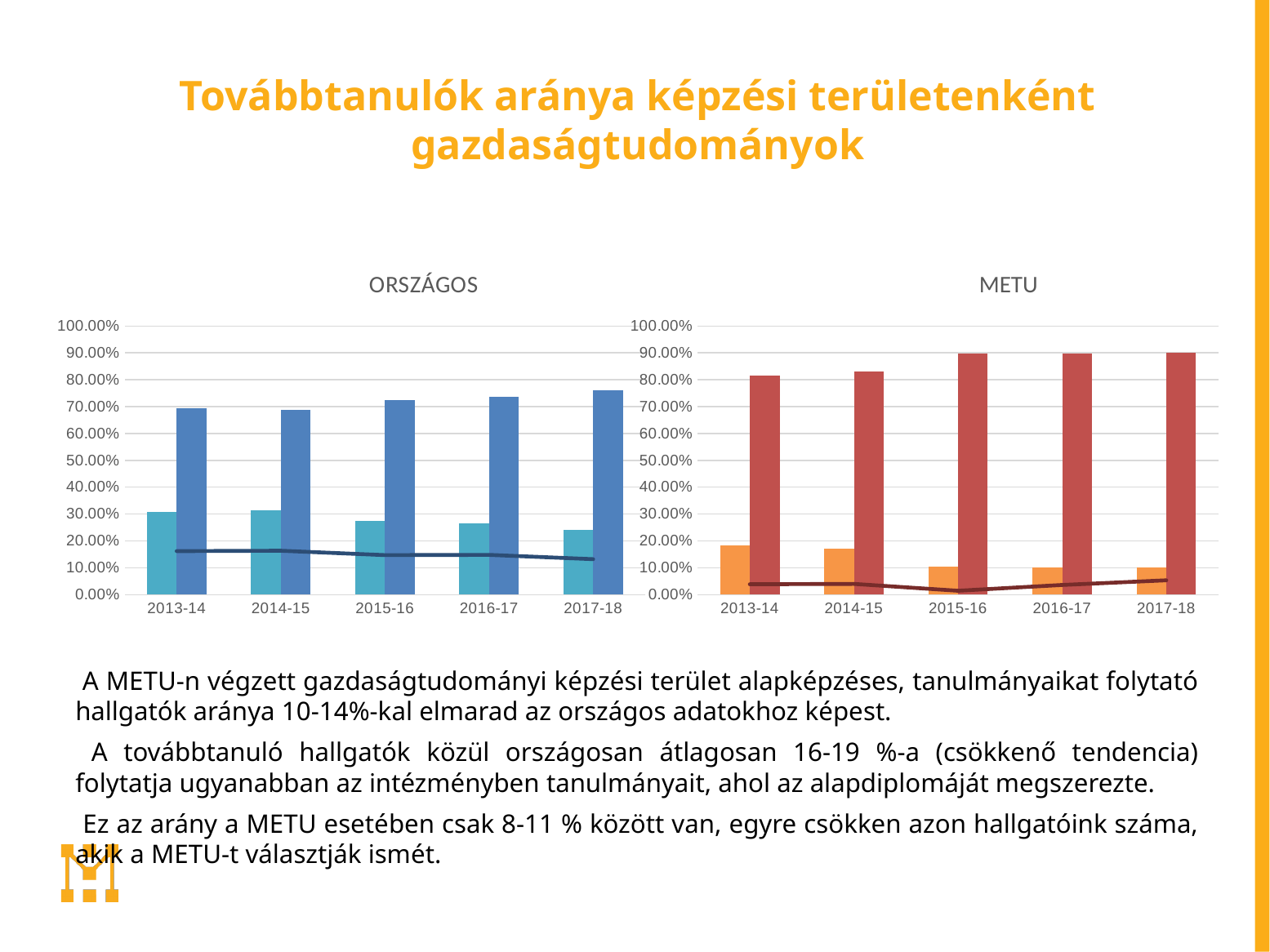
What are the titles of the two charts on the slide? ORSZÁGOS and METU What kind of chart is the ORSZÁGOS chart on the left? bar chart with a line In the ORSZÁGOS chart, which year has the shortest light blue bar? 2017-18 In the METU chart, is the orange bar for 2013-14 greater or less than 10.00%? greater How many academic years are shown on the x axis of the METU chart? 5 In the METU chart, which is larger: the orange bar for 2013-14 or the orange bar for 2015-16? 2013-14 In the ORSZÁGOS chart, which year has the tallest dark blue bar? 2017-18 In the ORSZÁGOS chart, is the light blue bar for 2017-18 greater or less than 30.00%? less In the METU chart, do the red bars generally rise or fall from 2013-14 to 2017-18? rise In the ORSZÁGOS chart, is the dark blue bar for 2017-18 greater or less than 70.00%? greater In the ORSZÁGOS chart, does the line rise or fall from 2013-14 to 2017-18? fall